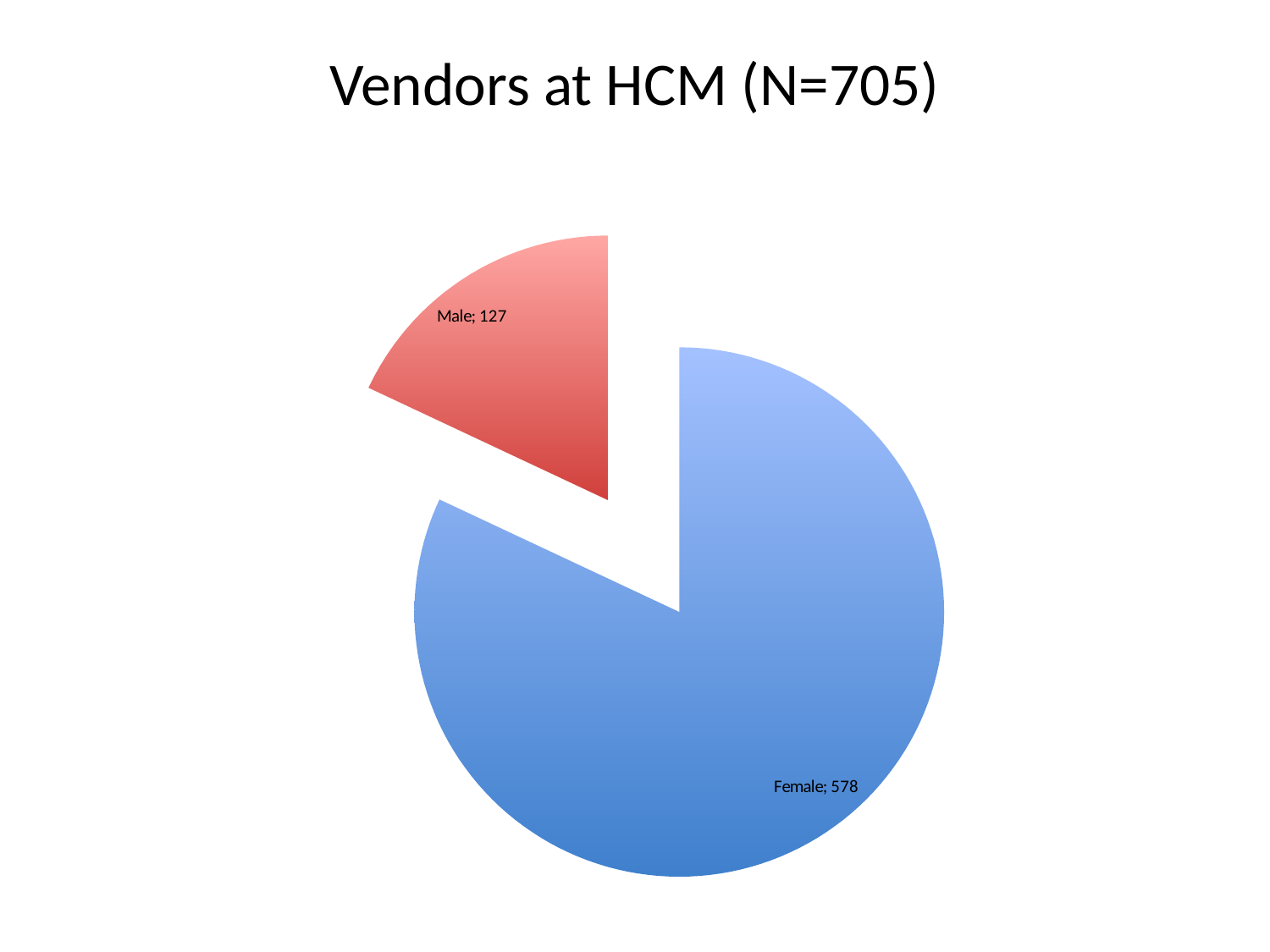
What is the total of the two slices? 705 What is the value for Female? 578 What is the difference between the Female and Male values? 451 Which category has the smallest slice? Male What kind of chart is shown on the slide? pie chart What is the title of the chart? Vendors at HCM (N=705) Which is larger, the value for Male or the value for Female? Female How many slices does the pie chart have? 2 Which category has the largest slice? Female What is the value for Male? 127 What colour is the Male slice? red